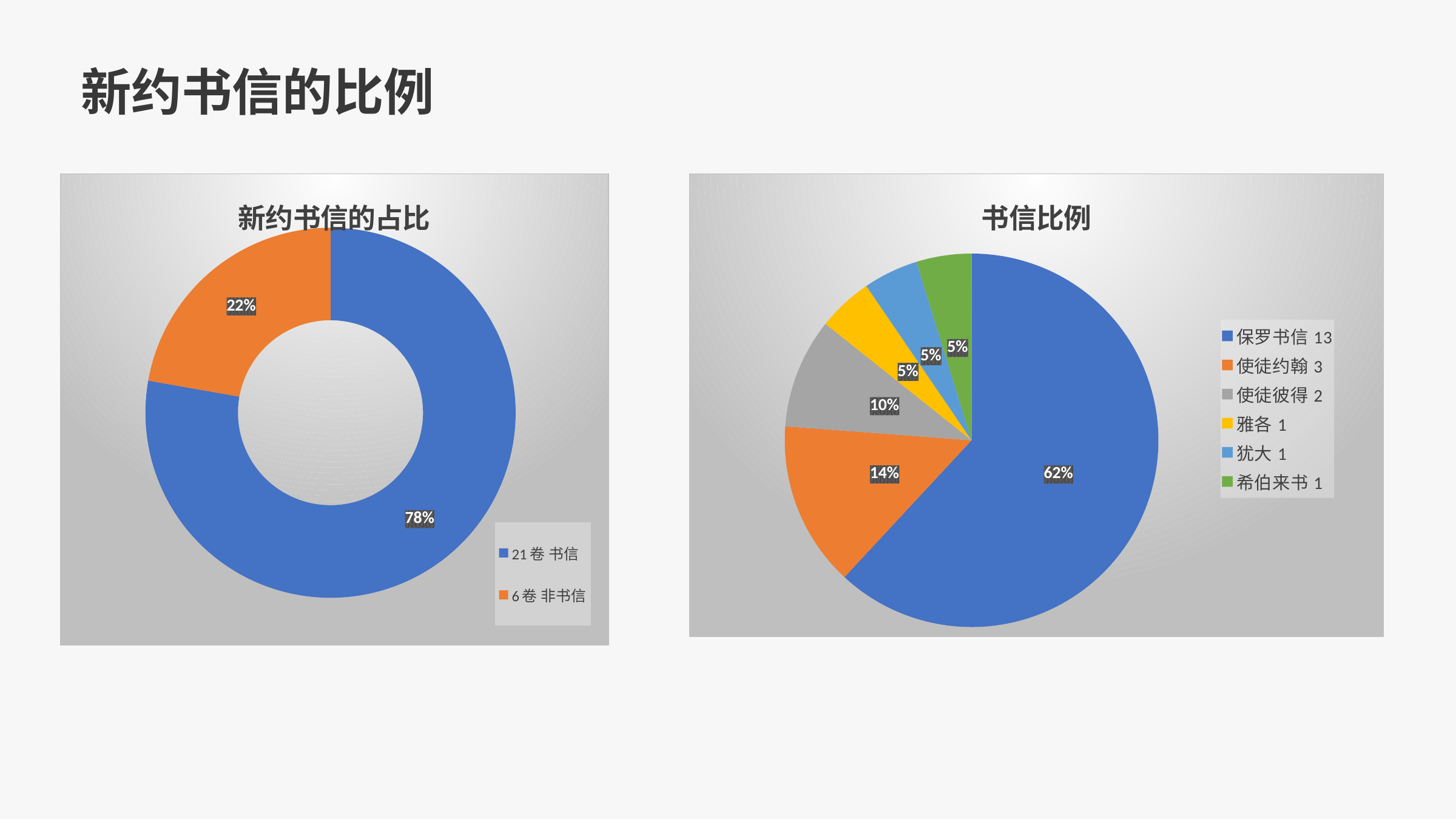
In the chart titled 书信比例, which category has the largest slice? 保罗书信 13 In the chart titled 新约书信的占比, what is the difference in percentage points between 21 卷 书信 and 6 卷 非书信? 56 In the chart titled 书信比例, what share does 使徒彼得 2 have? 10% In the chart titled 新约书信的占比, what share does 6 卷 非书信 have? 22% In the chart titled 书信比例, what share does 保罗书信 13 have? 62% In the chart titled 书信比例, which is larger, the slice for 使徒约翰 3 or the slice for 使徒彼得 2? 使徒约翰 3 In the chart titled 新约书信的占比, which category has the largest slice? 21 卷 书信 In the chart titled 书信比例, how many categories does the legend list? 6 What kind of chart is the chart titled 书信比例? Pie chart What kind of chart is the chart titled 新约书信的占比? Doughnut chart